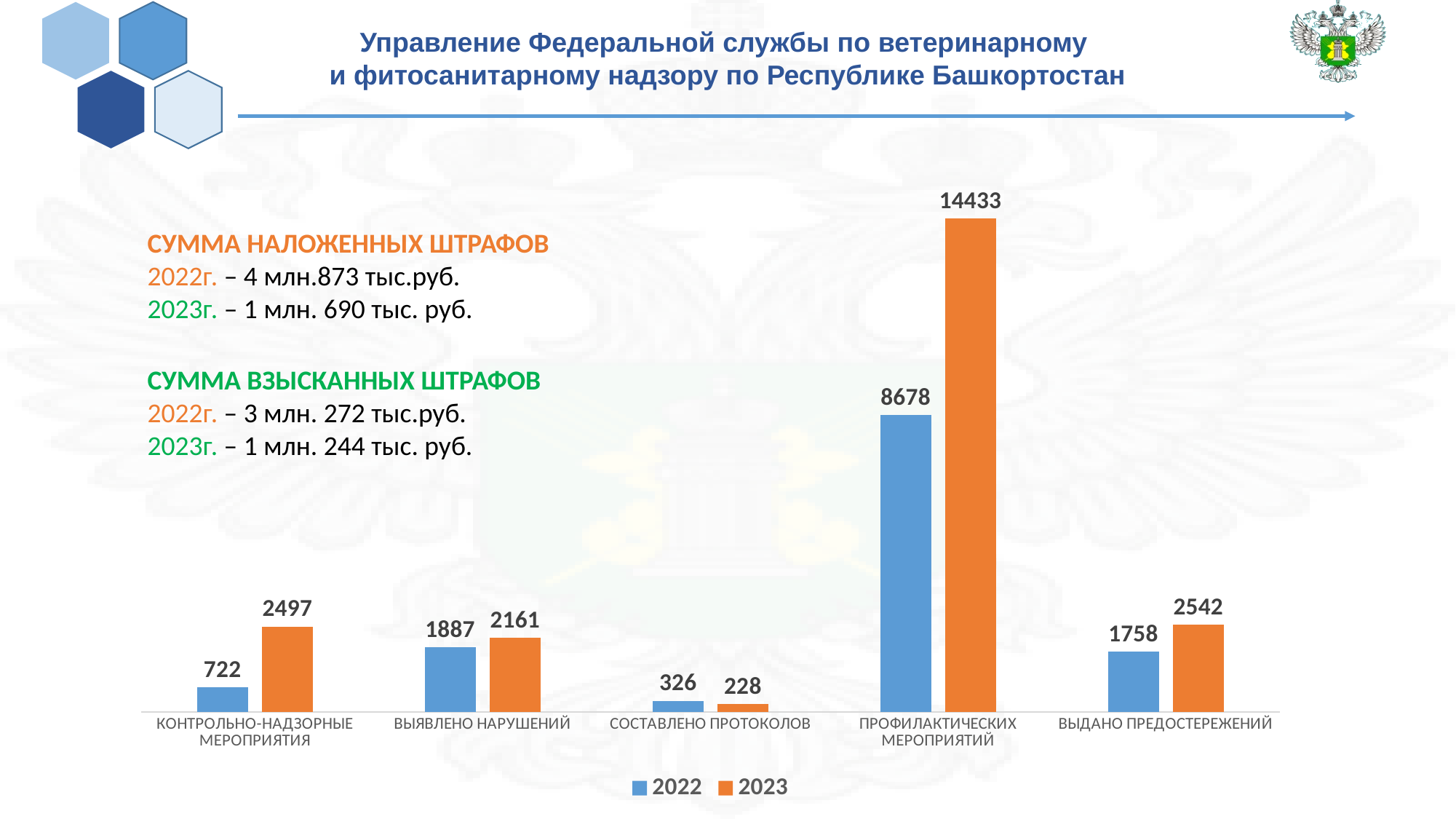
What is the difference between the 2023 and 2022 values for ПРОФИЛАКТИЧЕСКИХ МЕРОПРИЯТИЙ? 5755 Which category has the highest value for 2022? ПРОФИЛАКТИЧЕСКИХ МЕРОПРИЯТИЙ Which category has the lowest value for 2023? СОСТАВЛЕНО ПРОТОКОЛОВ What is the difference between the 2023 and 2022 values for ВЫЯВЛЕНО НАРУШЕНИЙ? 274 How many series does the legend list? 2 Which is larger for СОСТАВЛЕНО ПРОТОКОЛОВ, the 2022 value or the 2023 value? 2022 What is the value for 2022 in the КОНТРОЛЬНО-НАДЗОРНЫЕ МЕРОПРИЯТИЯ category? 722 How many categories are shown on the x axis of the chart? 5 What is the value for 2022 in the ВЫДАНО ПРЕДОСТЕРЕЖЕНИЙ category? 1758 What is the value for 2023 in the СОСТАВЛЕНО ПРОТОКОЛОВ category? 228 What is the value for 2023 in the ПРОФИЛАКТИЧЕСКИХ МЕРОПРИЯТИЙ category? 14433 What kind of chart is shown on the slide? bar chart